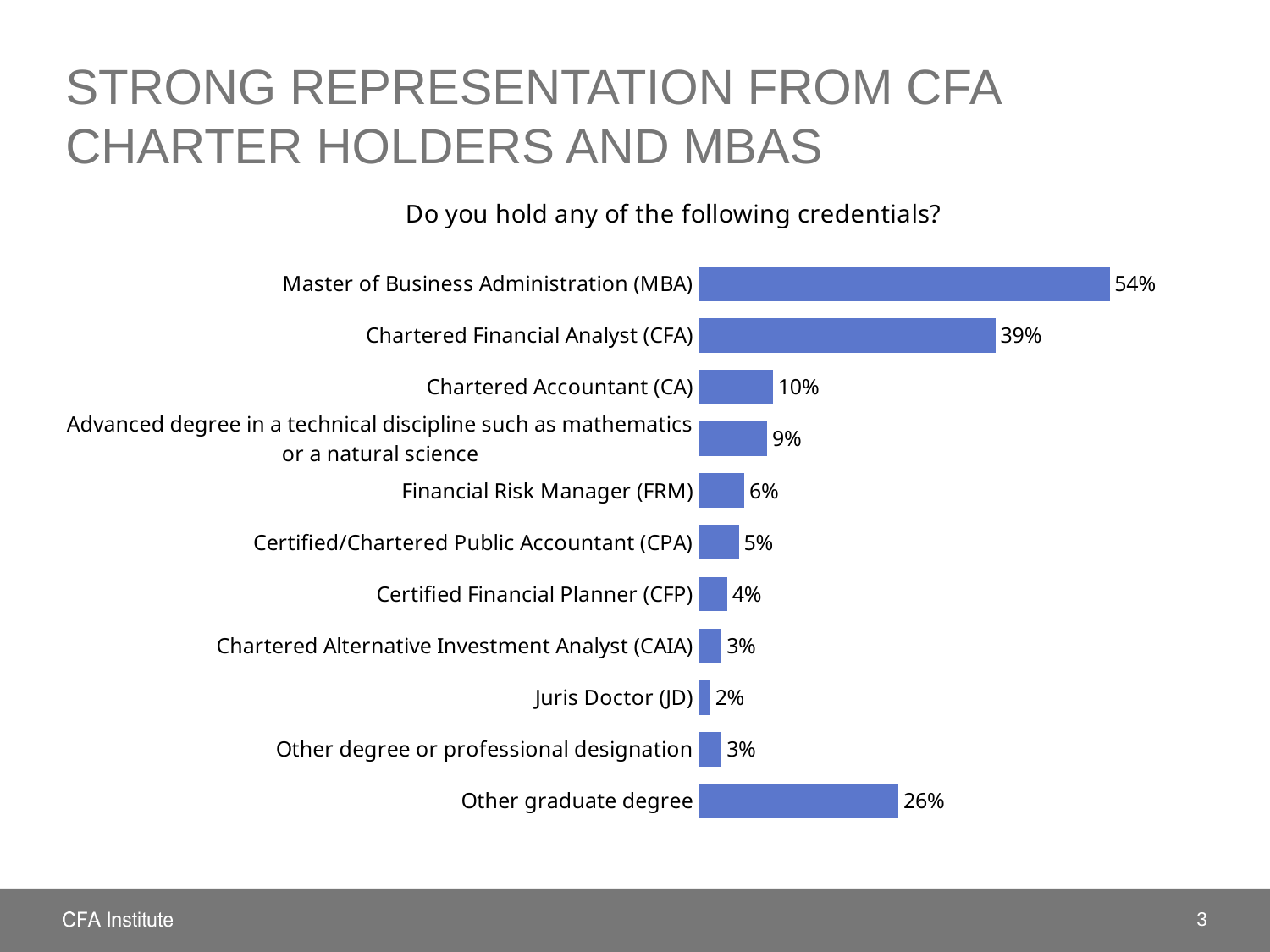
What is the difference between the MBA and CFA percentages? 15% What percentage of respondents hold an Other graduate degree? 26% Which credential has the highest percentage? Master of Business Administration (MBA) What is the value for Financial Risk Manager (FRM)? 6% Which credential has the lowest percentage? Juris Doctor (JD) How many credential categories are shown in the chart? 11 What percentage of respondents hold a Master of Business Administration (MBA)? 54% Which is larger, Other graduate degree or Chartered Accountant (CA)? Other graduate degree What type of chart is shown on the slide? Bar chart What is the difference between Chartered Accountant (CA) and Certified Financial Planner (CFP)? 6% What is the title of the chart? Do you hold any of the following credentials? What is the value for Chartered Financial Analyst (CFA)? 39%